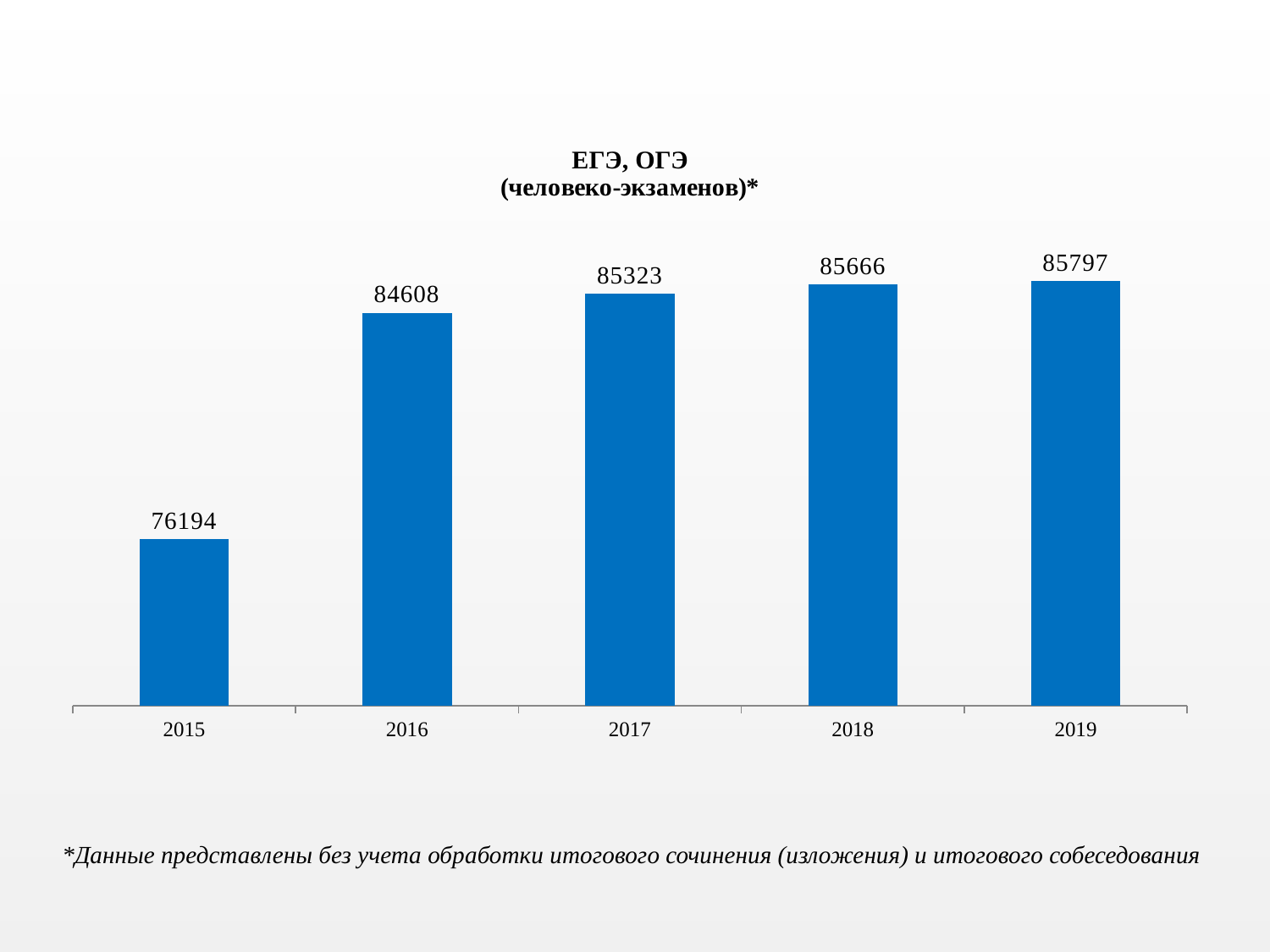
What is the difference between the values for 2019 and 2018? 131 What is the value for 2015? 76194 What kind of chart is this? bar chart Which is larger, the value for 2016 or the value for 2018? 2018 What is the difference between the values for 2016 and 2015? 8414 Which year has the lowest value? 2015 What is the value for 2019? 85797 Which year has the highest value? 2019 How many years are shown on the x axis? 5 Do the values rise or fall from 2015 to 2019? rise What is the title of the chart? ЕГЭ, ОГЭ (человеко-экзаменов)* What is the value for 2017? 85323